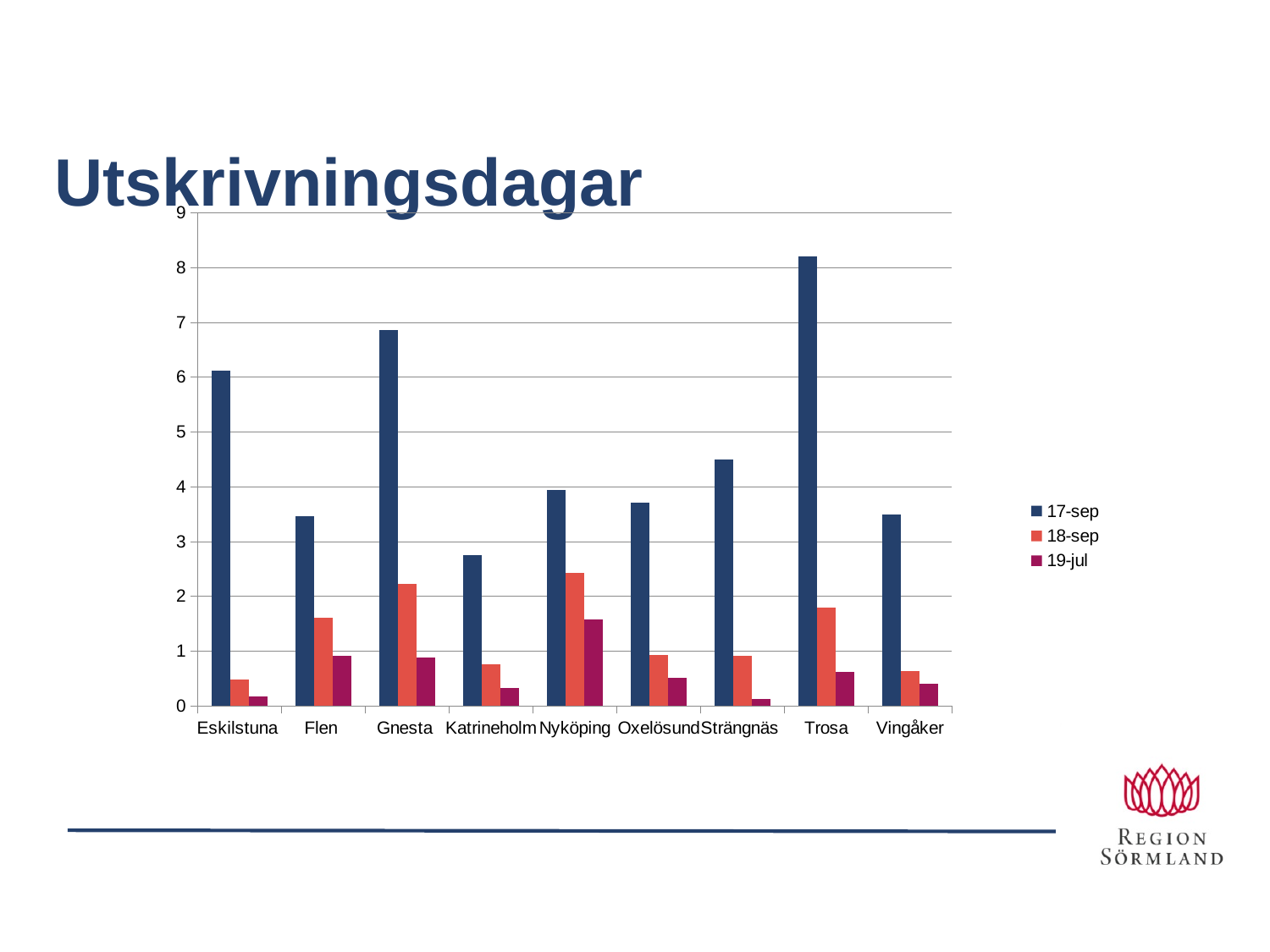
Which municipality has the lowest value for the 17-sep series? Katrineholm How many series does the legend list? 3 What type of chart is shown on the slide? bar chart Which is larger for the 17-sep series: Gnesta or Eskilstuna? Gnesta Is the 19-jul value for Nyköping greater or less than 1? greater Which is larger for the 17-sep series: Strängnäs or Oxelösund? Strängnäs What is the title of the chart? Utskrivningsdagar How many municipalities (categories) are shown on the x axis? 9 Which municipality has the highest value for the 17-sep series? Trosa Is the 17-sep value for Trosa greater or less than 8? greater Which municipality has the highest value for the 19-jul series? Nyköping Is the 17-sep value for Gnesta greater or less than 7? less